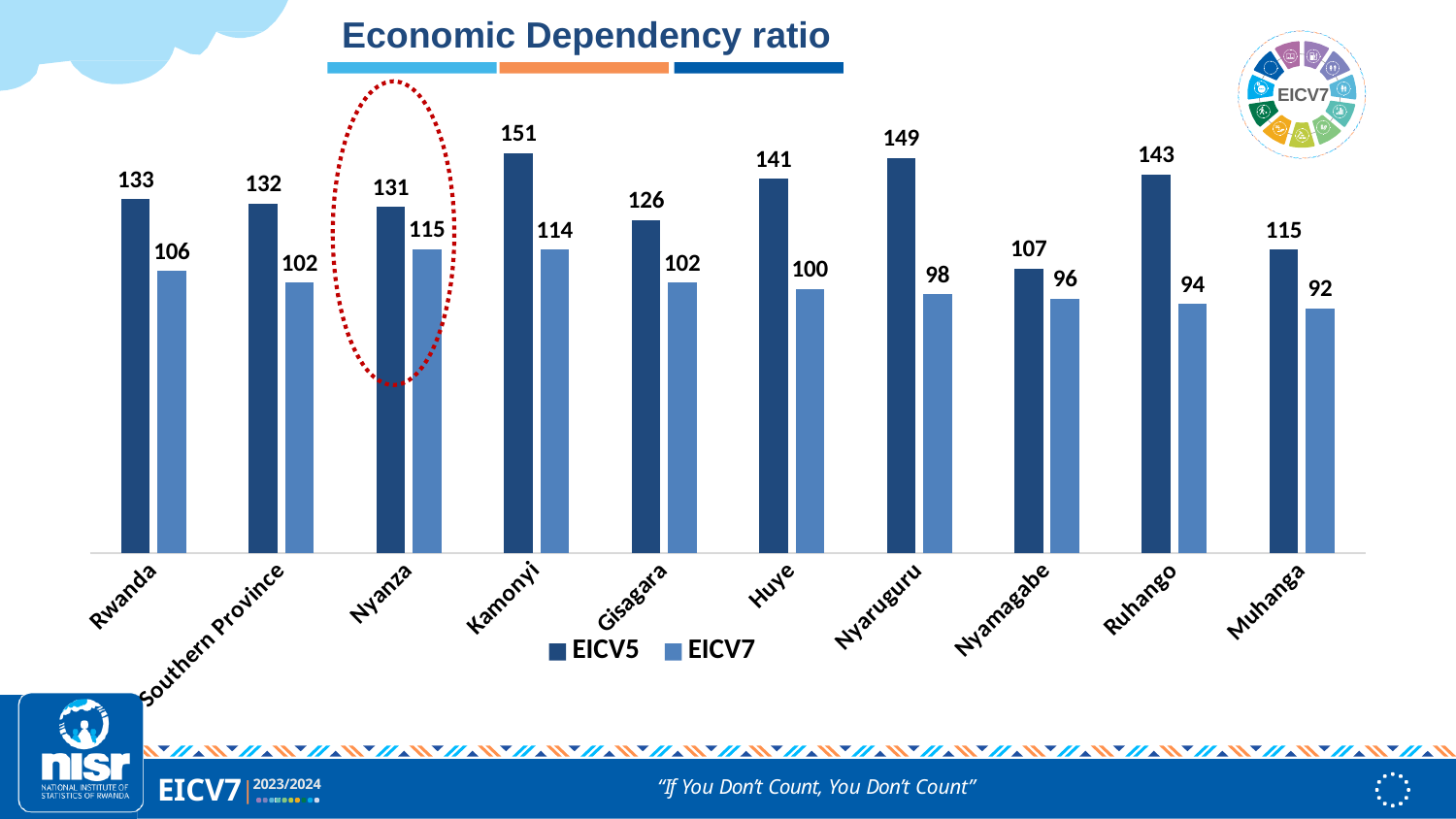
Which category has the lowest EICV5 value? Nyamagabe What is the EICV7 value for Rwanda? 106 What is the title of the chart? Economic Dependency ratio Which is larger, the EICV7 value for Nyanza or the EICV7 value for Kamonyi? Nyanza How many categories are shown on the x axis? 10 What is the EICV5 value for Kamonyi? 151 Which category has the highest EICV5 value? Kamonyi What is the EICV7 value for Nyanza? 115 How many series does the legend list? 2 Which category has the lowest EICV7 value? Muhanga What kind of chart is shown on the slide? Bar chart What is the difference between the EICV5 and EICV7 values for Ruhango? 49